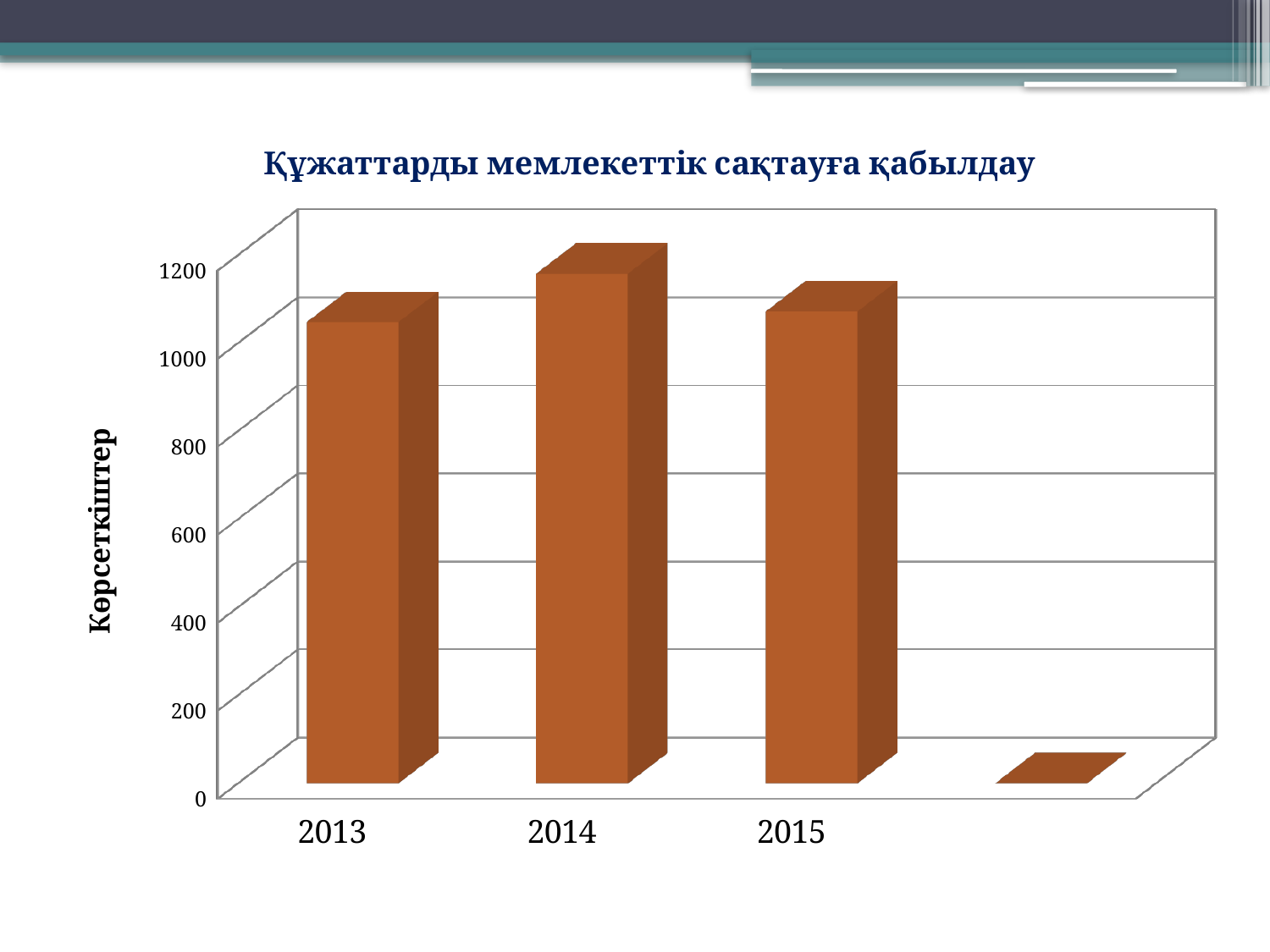
What is the label on the vertical axis of the chart? Көрсеткіштер Which year has the highest value in the chart? 2014 Which is larger, the value for 2013 or the value for 2014? 2014 Is the value for 2014 greater or less than 1200? less Does the value rise or fall from 2014 to 2015? fall Is the value for 2014 greater or less than 1000? greater Is the value for 2013 greater or less than 1000? greater How many years are labeled on the horizontal axis of the chart? 3 What kind of chart is shown on the slide? bar chart What is the title of the chart? Құжаттарды мемлекеттік сақтауға қабылдау Which is larger, the value for 2014 or the value for 2015? 2014